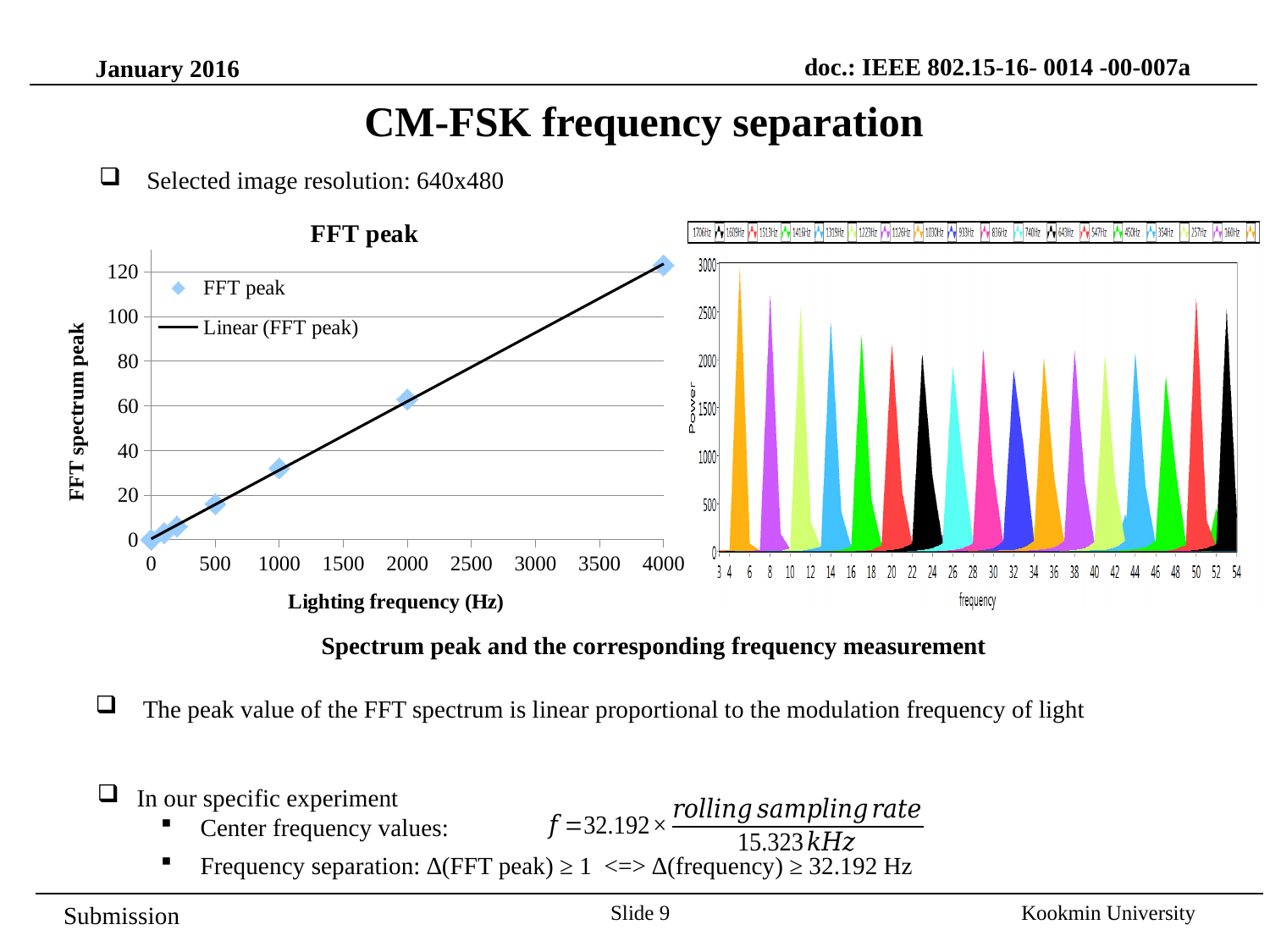
In the 'FFT peak' chart, is the FFT spectrum peak at a lighting frequency of 500 Hz greater or less than 20? less In the 'FFT peak' chart, do the FFT spectrum peak values rise or fall as the lighting frequency increases? rise What is the y-axis label of the spectrum chart on the right of the slide? Power How many frequency entries does the legend of the spectrum chart on the right of the slide list? 17 What is the x-axis title of the 'FFT peak' chart? Lighting frequency (Hz) In the 'FFT peak' chart, which has the larger FFT spectrum peak: the point at 2000 Hz or the point at 4000 Hz? 4000 Hz In the spectrum chart on the right, is the tallest peak greater or less than 2500 in power? greater How many entries does the legend of the 'FFT peak' chart list? 2 In the 'FFT peak' chart, is the FFT spectrum peak at a lighting frequency of 1000 Hz greater or less than 40? less What kind of chart is the 'FFT peak' chart on the left of the slide? scatter chart